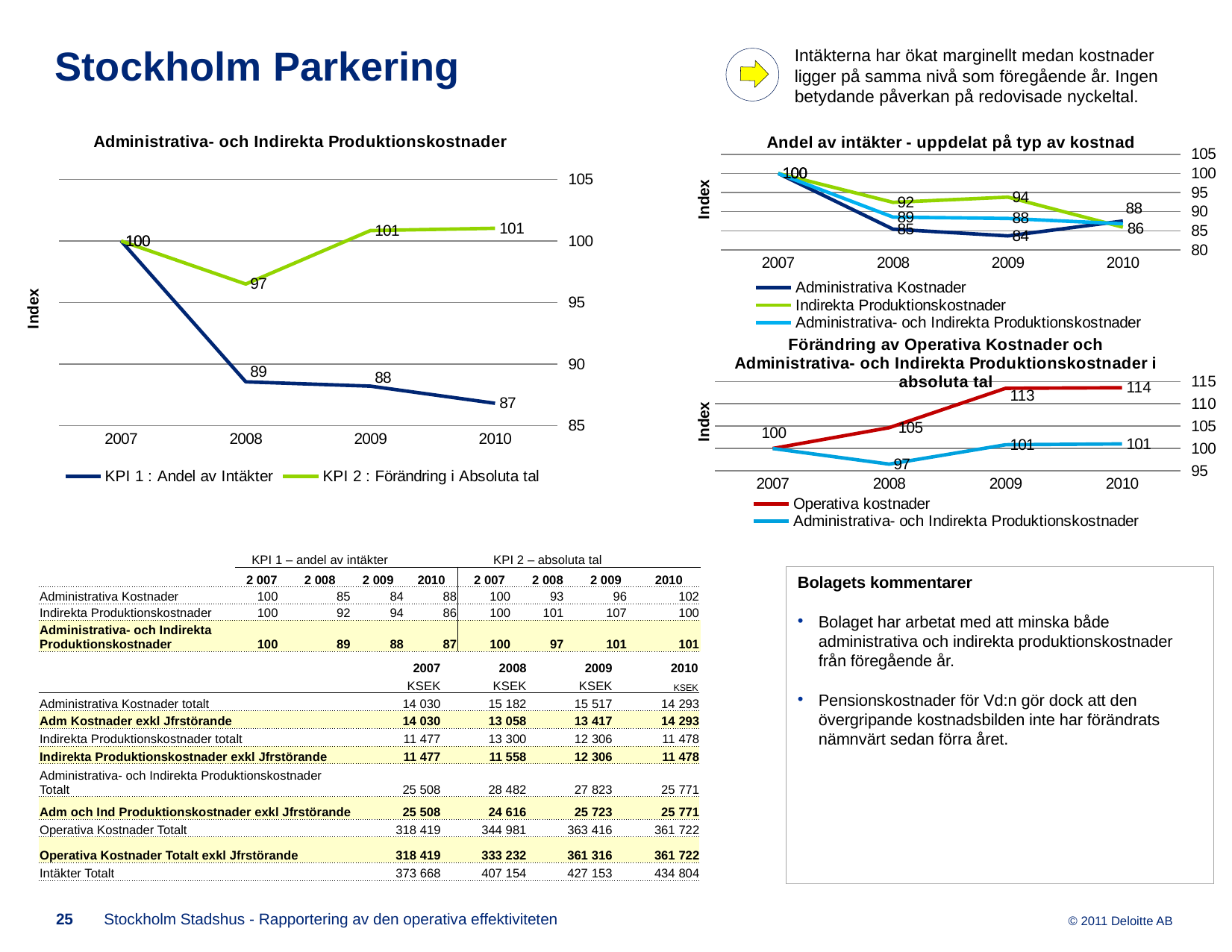
In the chart titled 'Förändring av Operativa Kostnader och Administrativa- och Indirekta Produktionskostnader i absoluta tal', which series is higher in 2009, Operativa kostnader or Administrativa- och Indirekta Produktionskostnader? Operativa kostnader In the chart titled 'Administrativa- och Indirekta Produktionskostnader', what is the value of KPI 2 : Förändring i Absoluta tal in 2008? 97 In the chart titled 'Administrativa- och Indirekta Produktionskostnader', in which year is KPI 1 : Andel av Intäkter lowest? 2010 In the chart titled 'Andel av intäkter - uppdelat på typ av kostnad', what is the value of Administrativa Kostnader in 2009? 84 In the chart titled 'Administrativa- och Indirekta Produktionskostnader', what is the value of KPI 1 : Andel av Intäkter in 2010? 87 What kind of chart is the chart titled 'Andel av intäkter - uppdelat på typ av kostnad'? line chart In the chart titled 'Administrativa- och Indirekta Produktionskostnader', does KPI 1 : Andel av Intäkter rise or fall from 2007 to 2010? fall How many series does the legend of the chart titled 'Andel av intäkter - uppdelat på typ av kostnad' list? 3 In the chart titled 'Förändring av Operativa Kostnader och Administrativa- och Indirekta Produktionskostnader i absoluta tal', what is the value of Operativa kostnader in 2010? 114 In the chart titled 'Administrativa- och Indirekta Produktionskostnader', what is the difference between KPI 2 and KPI 1 in 2010? 14 How many series does the legend of the chart titled 'Administrativa- och Indirekta Produktionskostnader' list? 2 In the chart titled 'Andel av intäkter - uppdelat på typ av kostnad', what is the value of Indirekta Produktionskostnader in 2008? 92